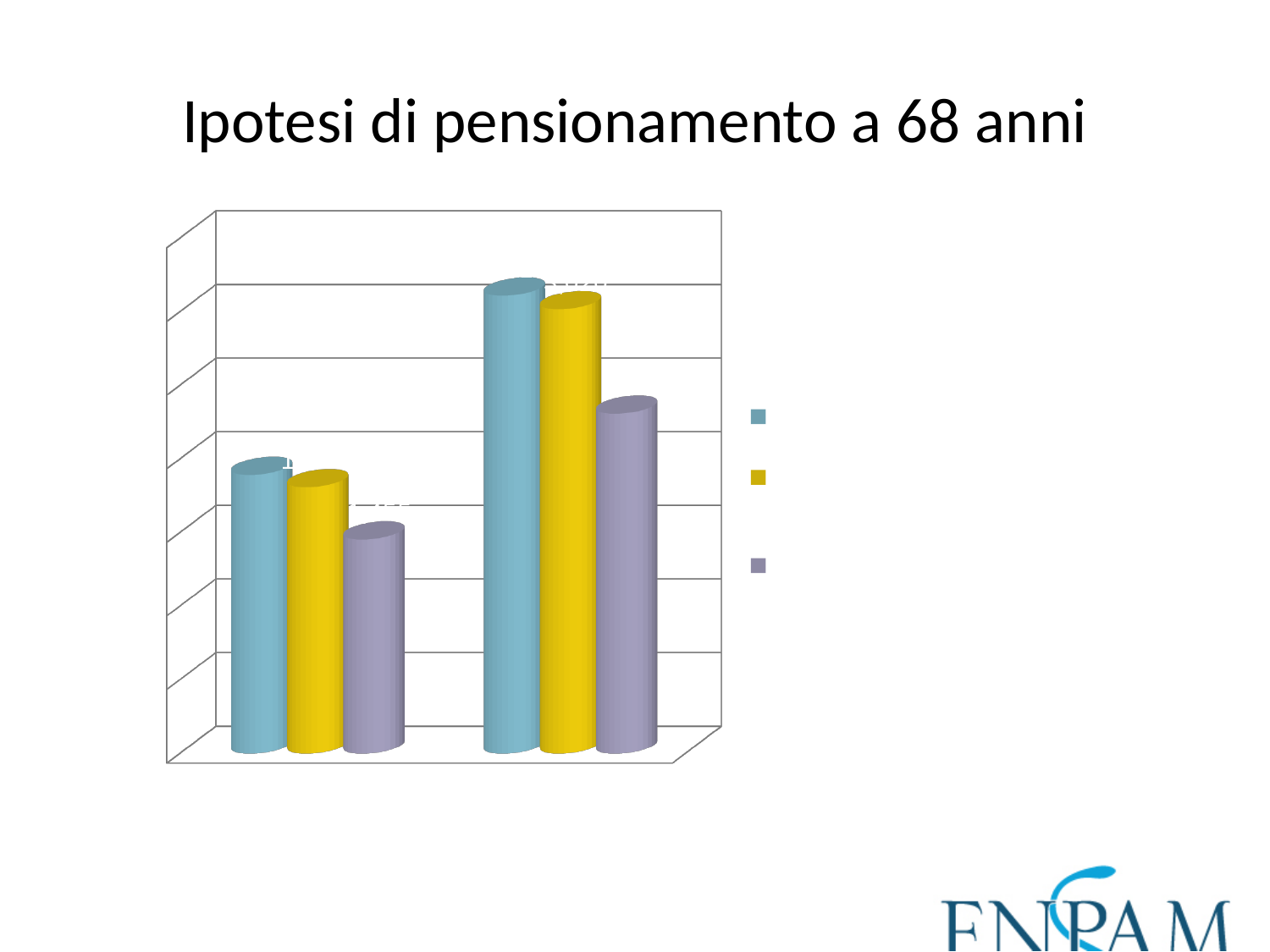
How many series does the chart's legend list? 3 What colours are the three series in the chart's legend, from top to bottom? blue, yellow, purple Do the bar heights rise or fall from the left group to the right group? rise Which is taller: the blue bar in the left group or the blue bar in the right group? the blue bar in the right group How many bars are plotted in total in the chart? 6 What is the title shown above the chart? Ipotesi di pensionamento a 68 anni In the right-hand group of bars, which coloured bar is the tallest? the blue bar Which is taller: the purple bar in the right group or the yellow bar in the left group? the purple bar in the right group How many groups of bars are plotted in the chart? 2 In the left-hand group of bars, which coloured bar is the shortest? the purple bar In the right-hand group of bars, which coloured bar is the shortest? the purple bar What kind of chart is shown on the slide? bar chart